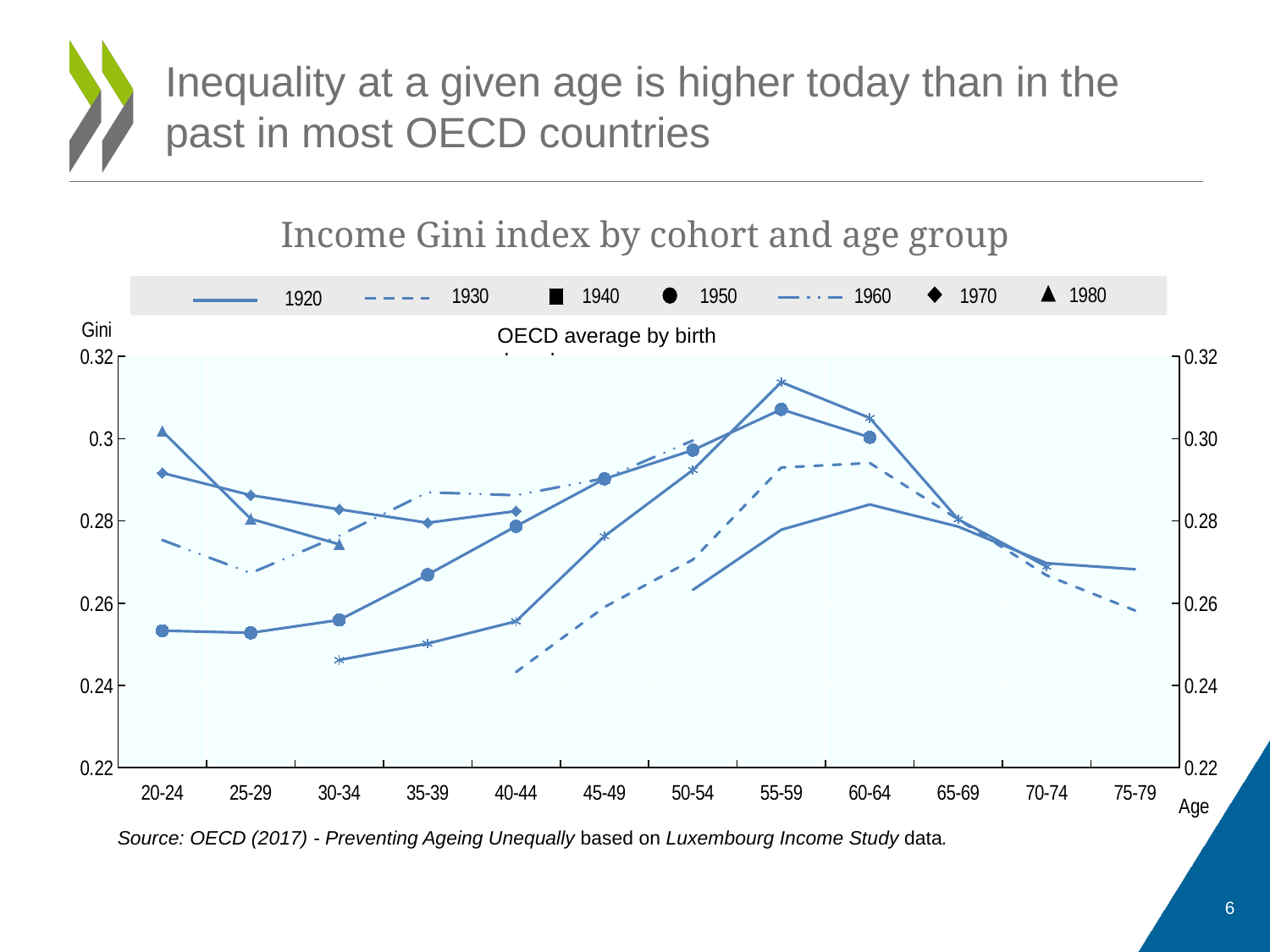
At age 20-24, which cohort has the higher Gini value, 1980 or 1950? 1980 What kind of chart is shown on the slide? Line chart How many series does the legend list? 7 Does the 1950 cohort's Gini value rise or fall from age 20-24 to age 55-59? Rise Is the value for the 1920 cohort at age 60-64 greater or less than 0.30? less At age 55-59, which cohort has the higher Gini value, 1940 or 1920? 1940 What is the title of the chart? Income Gini index by cohort and age group Is the value for the 1930 cohort at age 40-44 greater or less than 0.26? less What is the label of the x axis? Age Is the value for the 1950 cohort at age 20-24 greater or less than 0.26? less How many age groups are shown on the x axis? 12